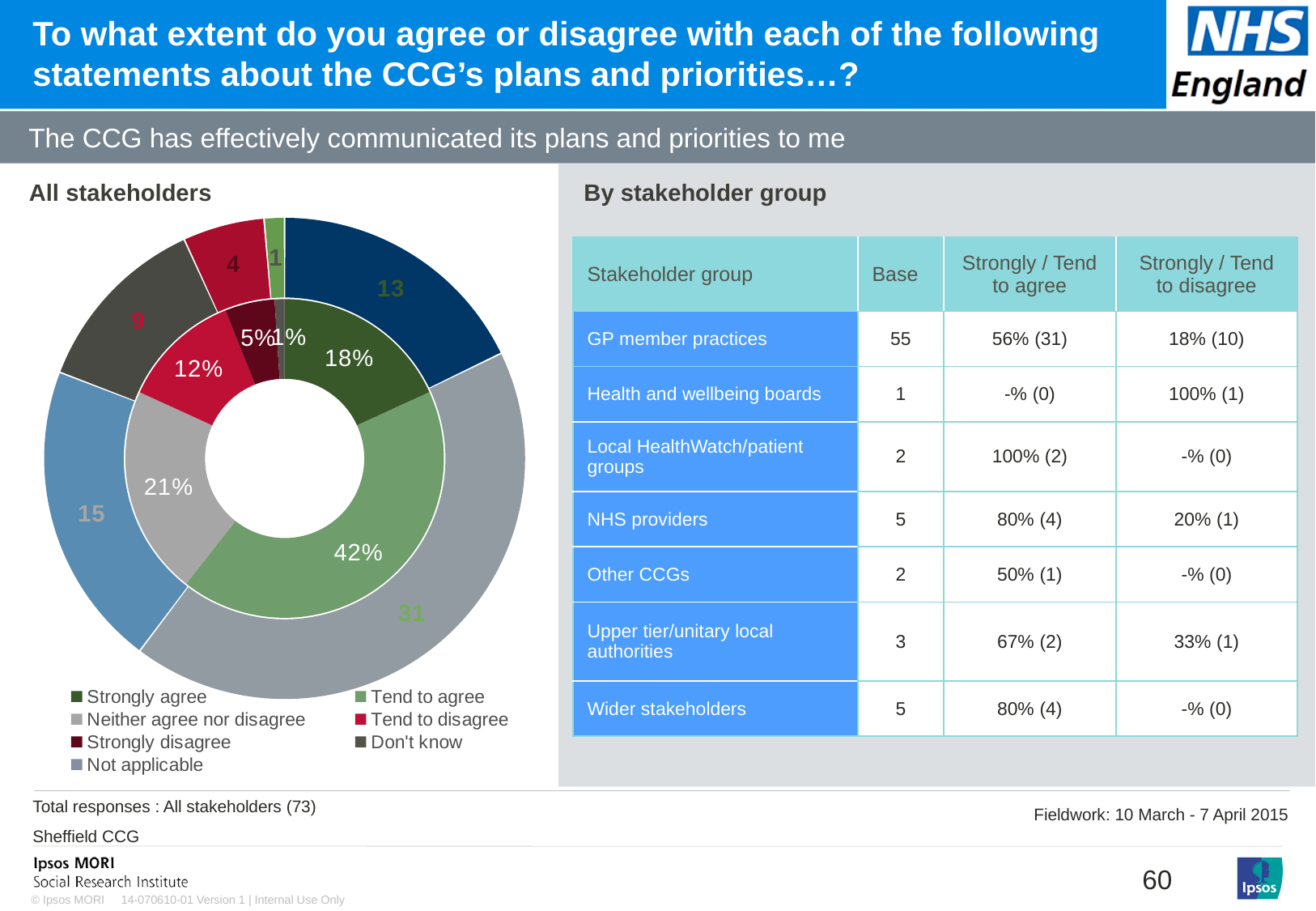
In the 'All stakeholders' chart, what percentage is shown for 'Tend to agree'? 42% In the 'All stakeholders' chart, what percentage is shown for 'Tend to disagree'? 12% What kind of chart is shown under the heading 'All stakeholders'? Doughnut chart How many response categories are listed in the legend of the 'All stakeholders' chart? 7 In the 'All stakeholders' chart, what percentage is shown for 'Strongly disagree'? 5% In the 'All stakeholders' chart, what percentage is shown for 'Strongly agree'? 18% In the 'All stakeholders' chart, which is larger: 'Neither agree nor disagree' or 'Tend to disagree'? Neither agree nor disagree What heading appears above the doughnut chart on the left of the slide? All stakeholders In the 'All stakeholders' chart, which response category has the largest share? Tend to agree In the 'All stakeholders' chart, how many percentage points higher is 'Tend to agree' than 'Strongly agree'? 24 percentage points In the 'All stakeholders' chart, what percentage is shown for 'Neither agree nor disagree'? 21% In the 'All stakeholders' chart, what is the combined percentage of 'Strongly agree' and 'Tend to agree'? 60%